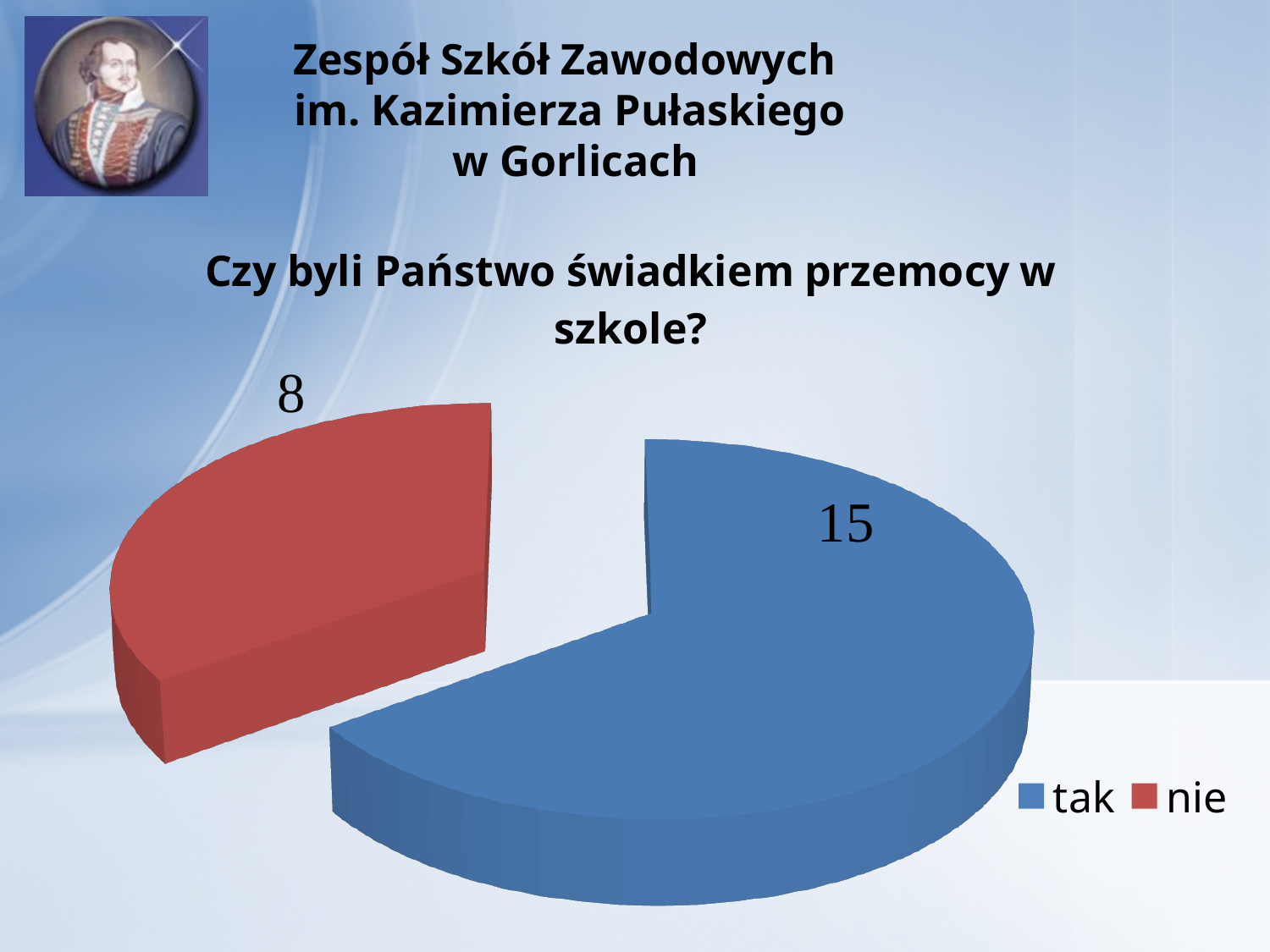
How many categories does the pie chart show? 2 What is the difference between the values for "tak" and "nie"? 7 Which category has the smallest slice? nie What colour is the "nie" slice? red Which is larger, the value for "tak" or the value for "nie"? tak What is the value for "nie"? 8 What is the total of the two slices? 23 What kind of chart is shown on the slide? pie chart Which category has the largest slice? tak What is the title of the chart? Czy byli Państwo świadkiem przemocy w szkole? What is the value for "tak"? 15